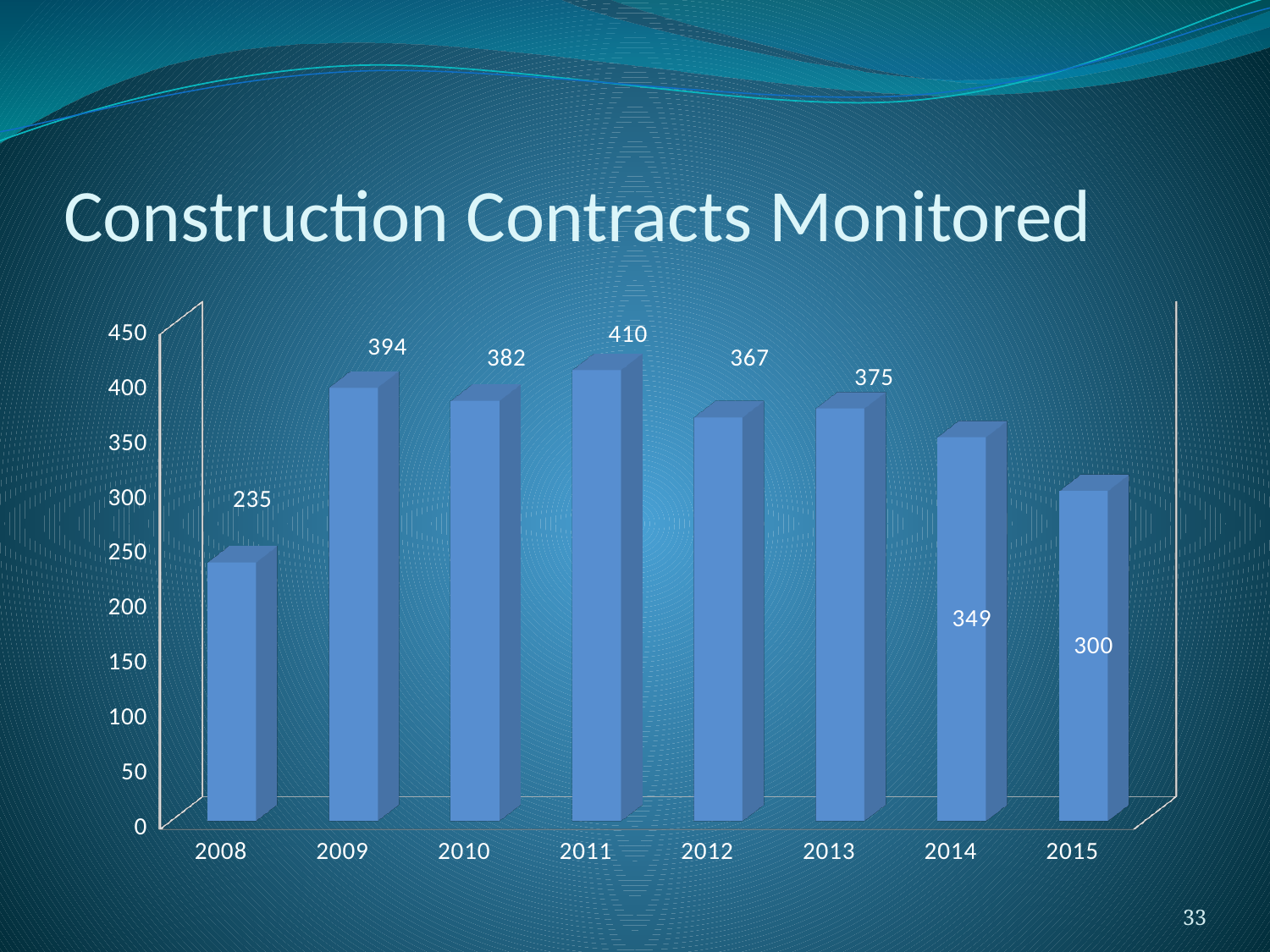
What is the difference between the values for 2009 and 2010? 12 Is the value for 2015 greater or less than 350? less What is the value for 2011? 410 What is the difference between the values for 2011 and 2015? 110 Which is larger, the value for 2012 or the value for 2013? 2013 Do the values rise or fall from 2011 to 2015? fall What is the value for 2014? 349 Which year has the highest value? 2011 What kind of chart is shown on the slide? bar chart How many years are shown on the x axis? 8 Which year has the lowest value? 2008 What is the value for 2008? 235